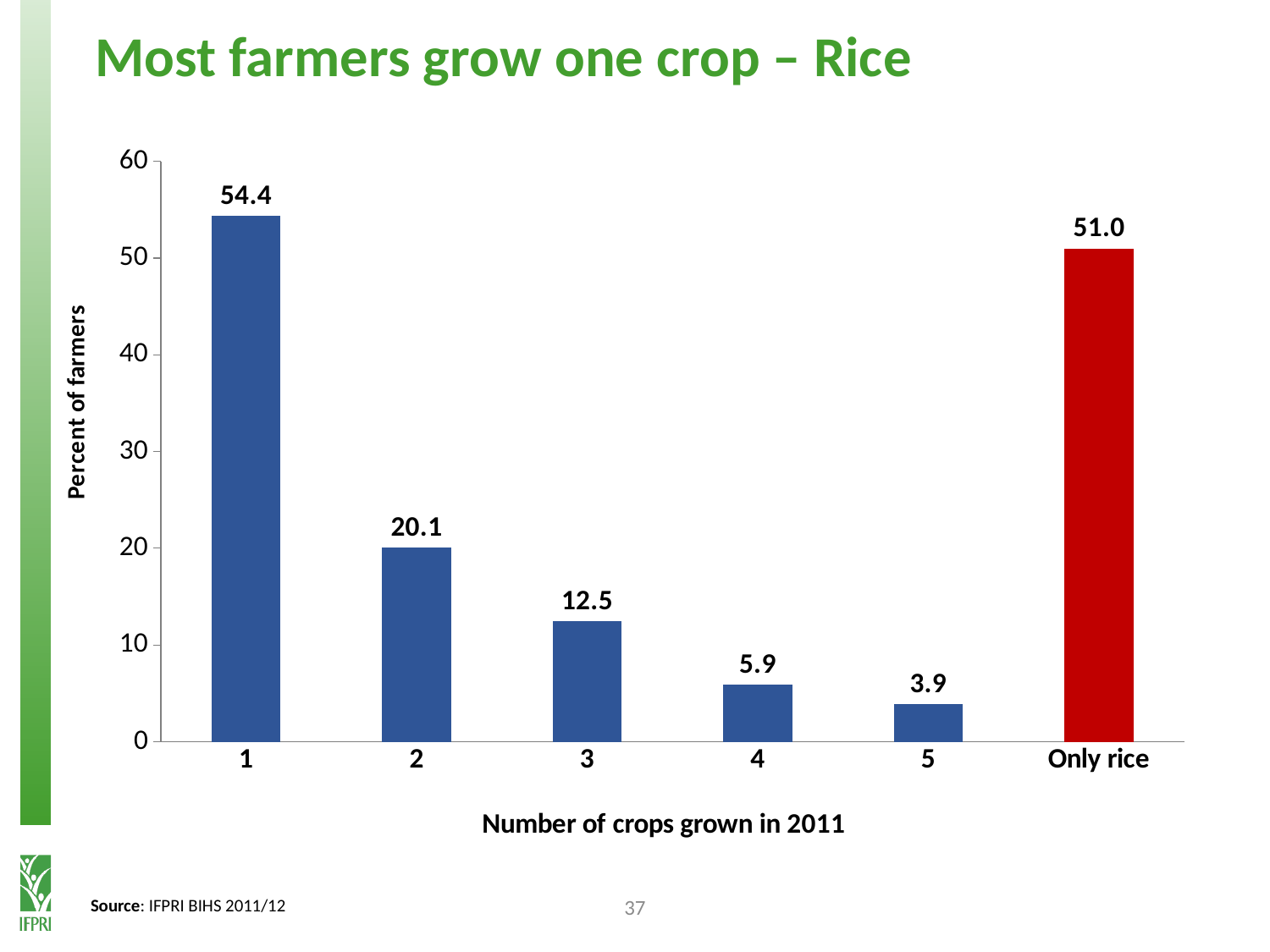
What percent of farmers grew 3 crops in 2011? 12.5 Which is larger, the value for 1 crop or the value for 'Only rice'? 1 crop What is the value for the 'Only rice' bar? 51.0 Is the value for 2 crops greater or less than 30? less How many bars are shown in the chart? 6 What kind of chart is shown on the slide? bar chart Which category has the highest percent of farmers? 1 What is the difference between the values for 1 crop and 2 crops? 34.3 What is the label of the y axis? Percent of farmers What is the difference between the values for 4 crops and 5 crops? 2.0 What percent of farmers grew 1 crop in 2011? 54.4 Which category has the lowest percent of farmers? 5